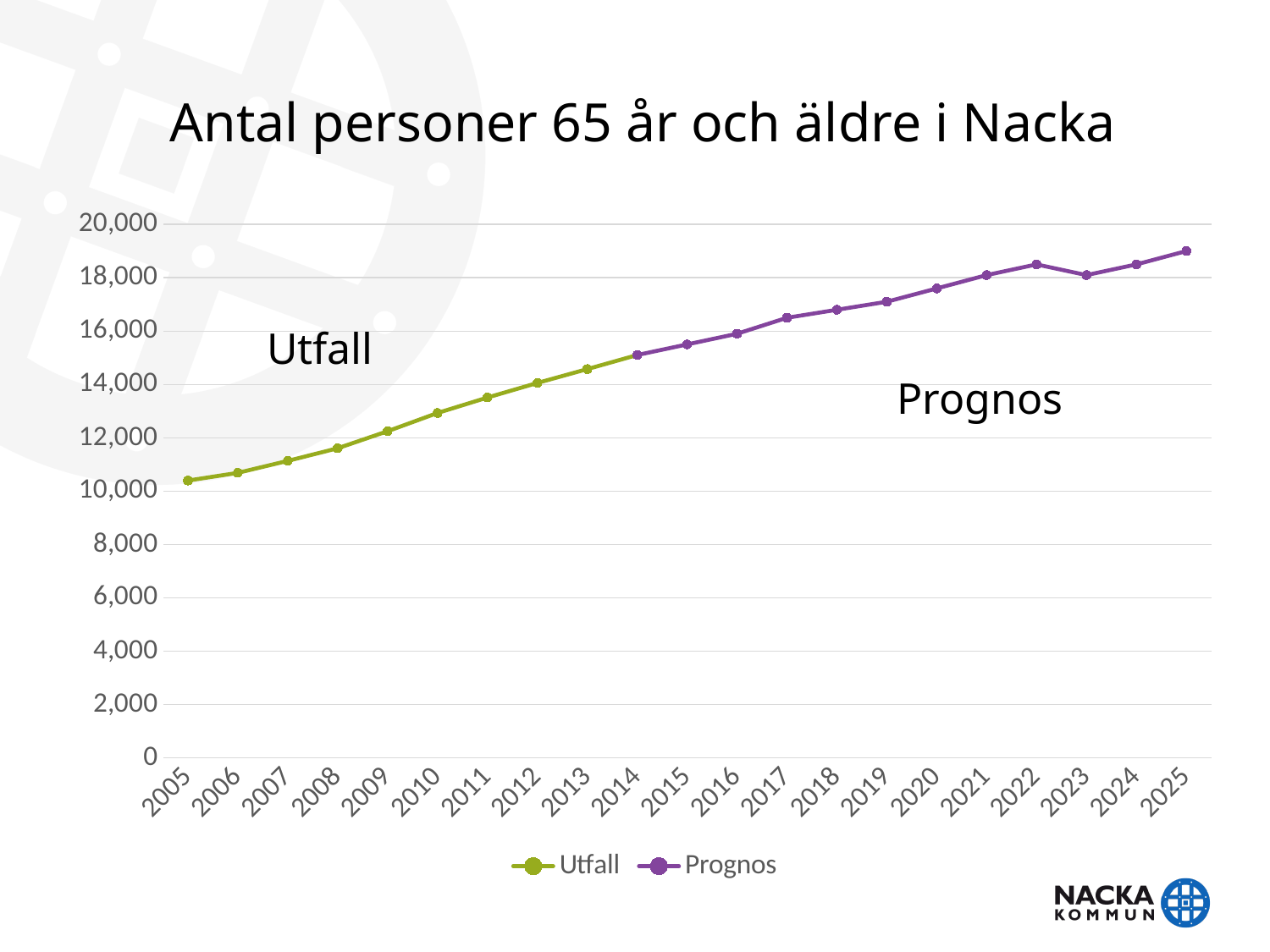
Which is larger, the value for 2022 or the value for 2023? 2022 How many series does the legend list? 2 Do the values generally rise or fall from 2005 to 2025? rise What is the title of the chart? Antal personer 65 år och äldre i Nacka What are the names of the two series in the legend? Utfall and Prognos What kind of chart is shown on the slide? line chart How many years are shown on the x axis? 21 Is the value for 2014 greater or less than 16,000? less Is the value for 2025 greater or less than 18,000? greater Is the value for 2005 greater or less than 12,000? less Which year has the lowest value on the chart? 2005